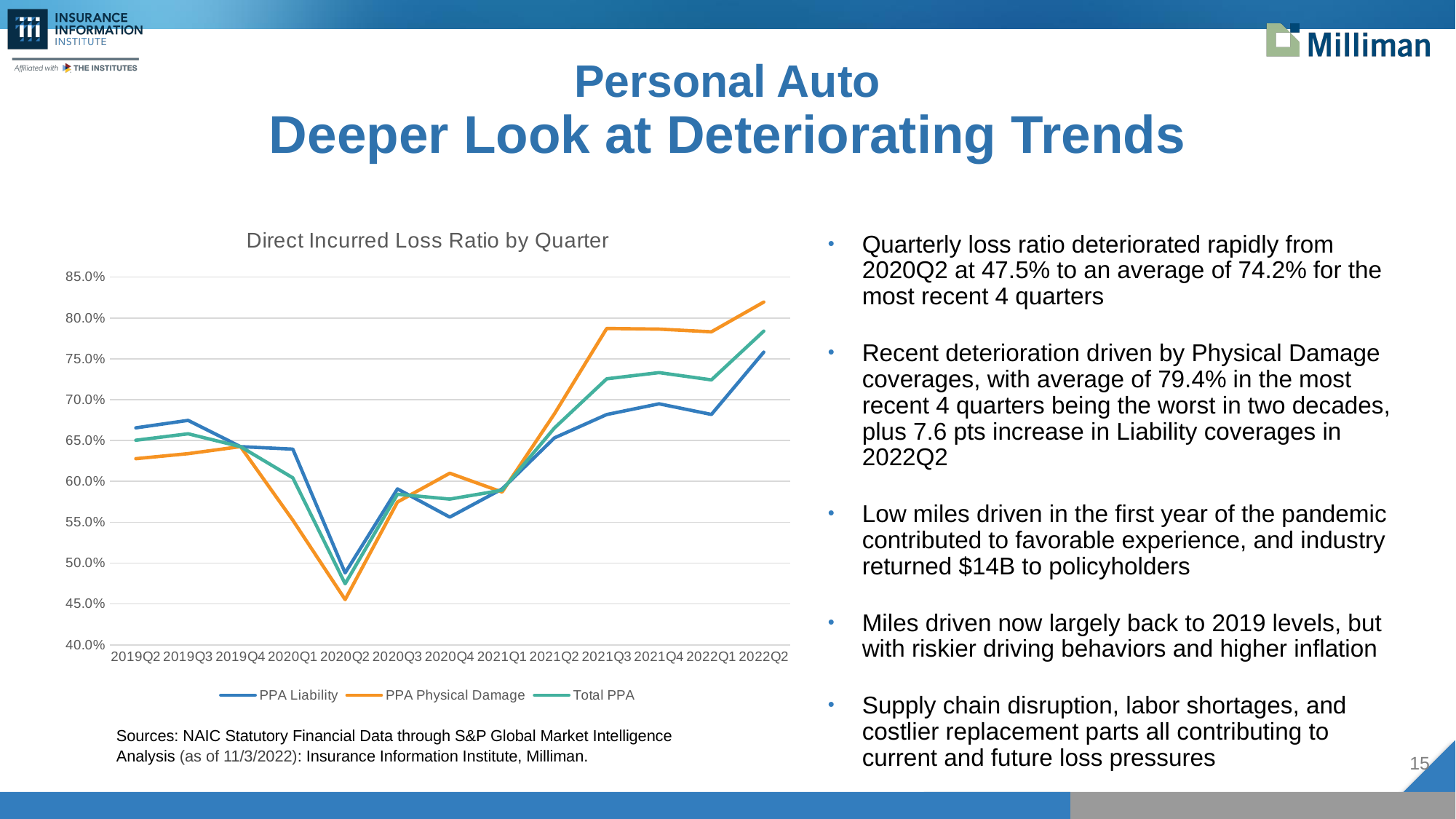
Is the value for Total PPA in 2021Q3 greater or less than 70.0%? greater Is the value for PPA Physical Damage in 2022Q2 greater or less than 80.0%? greater In 2022Q2, which is higher: PPA Liability or PPA Physical Damage? PPA Physical Damage What is the title of the chart? Direct Incurred Loss Ratio by Quarter In which quarter does the PPA Physical Damage series reach its lowest value? 2020Q2 Does the PPA Physical Damage series rise or fall from 2021Q1 to 2022Q2? Rise What kind of chart is shown on the slide? Line chart In which quarter does the PPA Physical Damage series reach its highest value? 2022Q2 How many series does the legend of the chart list? 3 Which series is shown in orange in the chart? PPA Physical Damage Is the value for PPA Physical Damage in 2020Q2 greater or less than 50.0%? less How many quarters are plotted along the x axis of the chart? 13